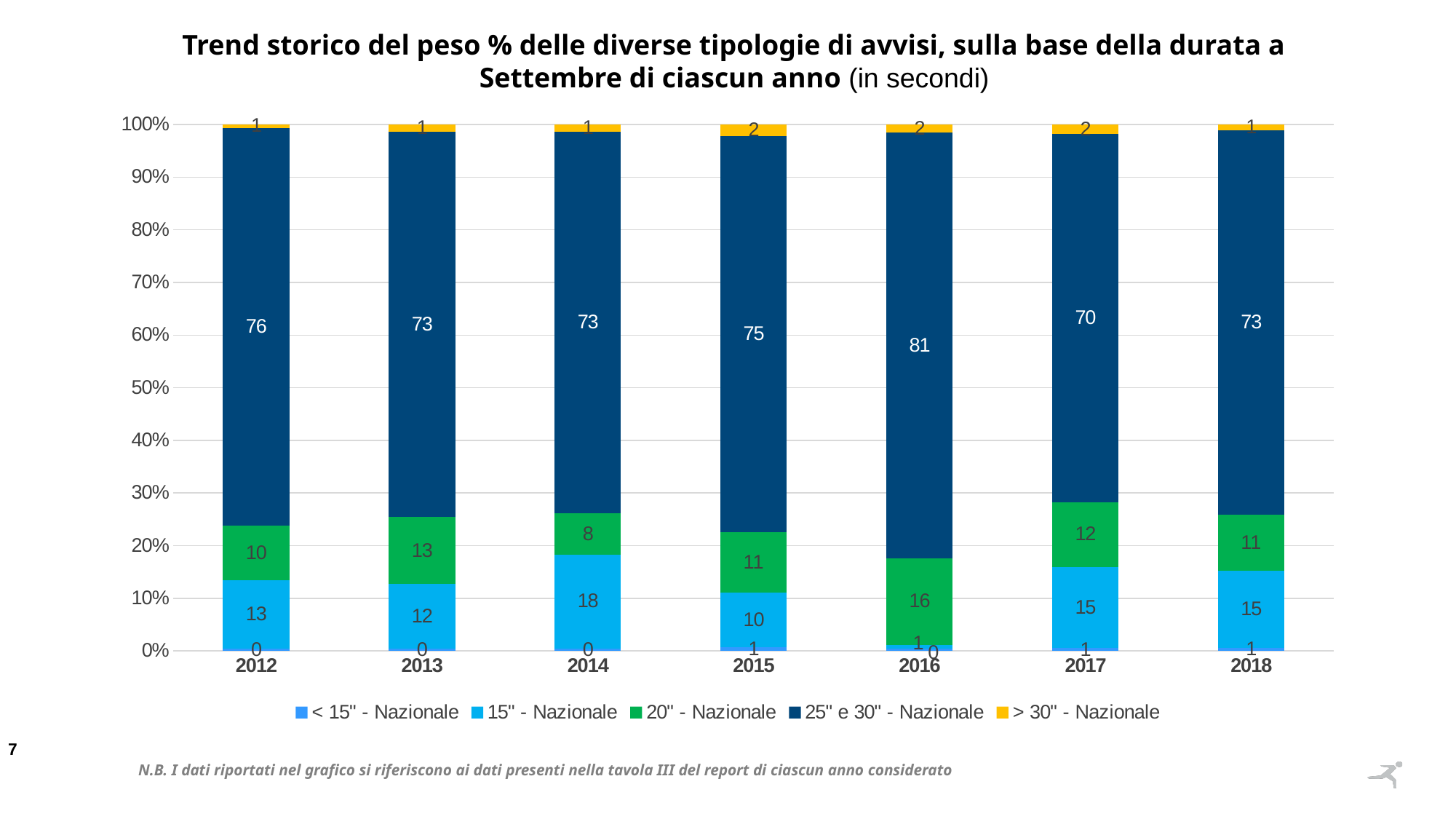
In which year is the 25'' e 30'' - Nazionale value lowest? 2017 Which is larger: the 20'' - Nazionale value in 2016 or in 2014? 2016 What kind of chart is shown on the slide? Stacked bar chart In which year is the 25'' e 30'' - Nazionale value highest? 2016 What is the value for the 25'' e 30'' - Nazionale series in 2016? 81 What is the value for the 15'' - Nazionale series in 2014? 18 What is the difference between the 25'' e 30'' - Nazionale values in 2016 and 2017? 11 What is the value for the 20'' - Nazionale series in 2013? 13 What is the value for the > 30'' - Nazionale series in 2015? 2 How many series does the legend list? 5 How many years are shown on the x axis? 7 In which year is the 15'' - Nazionale value lowest? 2016